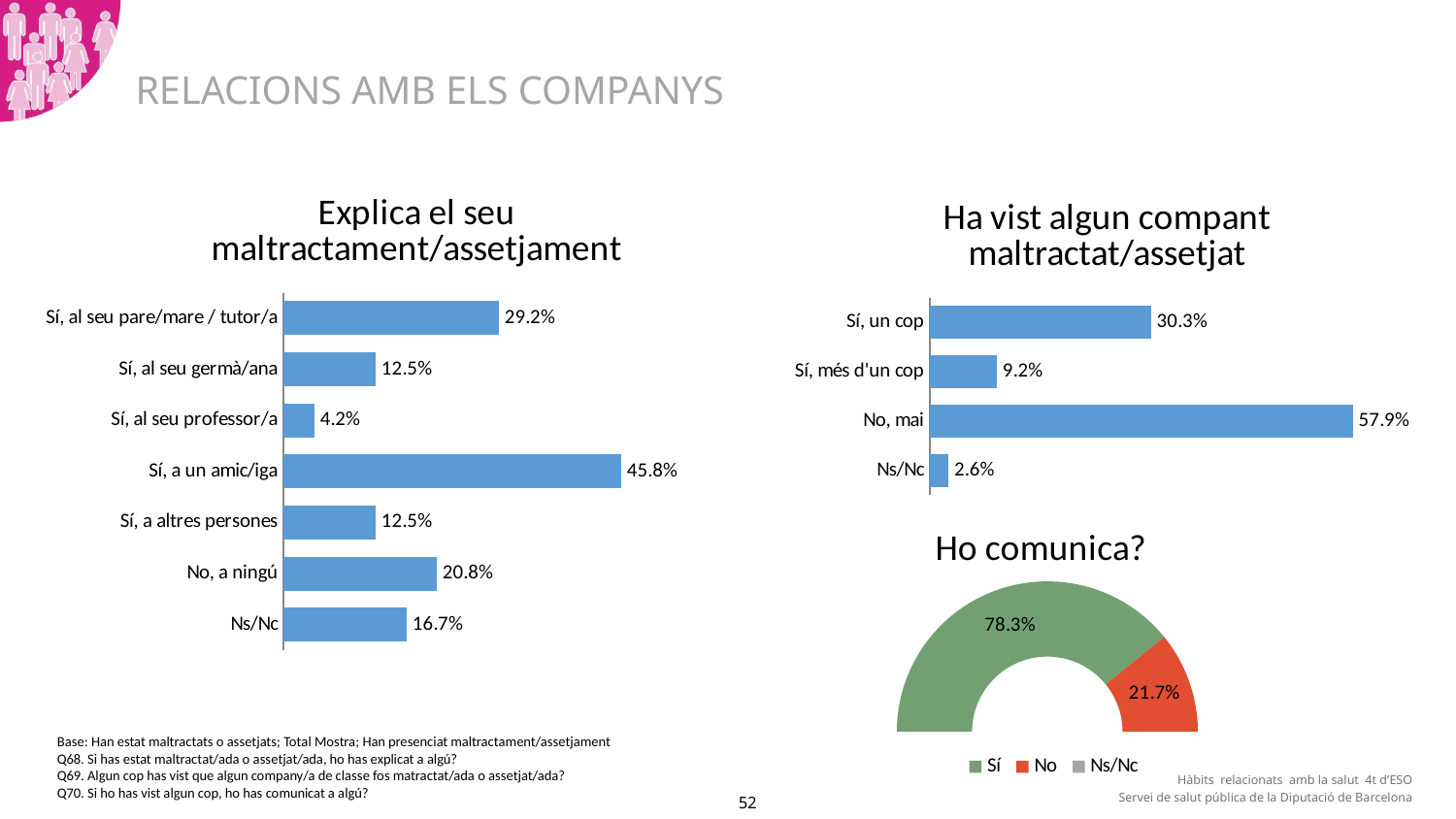
In the chart 'Explica el seu maltractament/assetjament', which category has the highest value? Sí, a un amic/iga In the chart 'Explica el seu maltractament/assetjament', how many categories are shown? 7 In the chart 'Explica el seu maltractament/assetjament', which category has the lowest value? Sí, al seu professor/a In the chart 'Ha vist algun compant maltractat/assetjat', which is larger: 'Sí, un cop' or 'Sí, més d'un cop'? Sí, un cop In the chart 'Ha vist algun compant maltractat/assetjat', what is the value for 'No, mai'? 57.9% In the chart 'Explica el seu maltractament/assetjament', what is the value for 'Ns/Nc'? 16.7% In the chart 'Ho comunica?', what is the share for 'Sí'? 78.3% In the chart 'Explica el seu maltractament/assetjament', what is the value for 'Sí, a un amic/iga'? 45.8% In the chart 'Ho comunica?', how many entries does the legend list? 3 In the chart 'Ha vist algun compant maltractat/assetjat', how many categories are shown? 4 In the chart 'Ha vist algun compant maltractat/assetjat', what is the difference between 'Sí, un cop' and 'Sí, més d'un cop'? 21.1% In the chart 'Explica el seu maltractament/assetjament', what is the difference between 'Sí, al seu pare/mare / tutor/a' and 'No, a ningú'? 8.4%